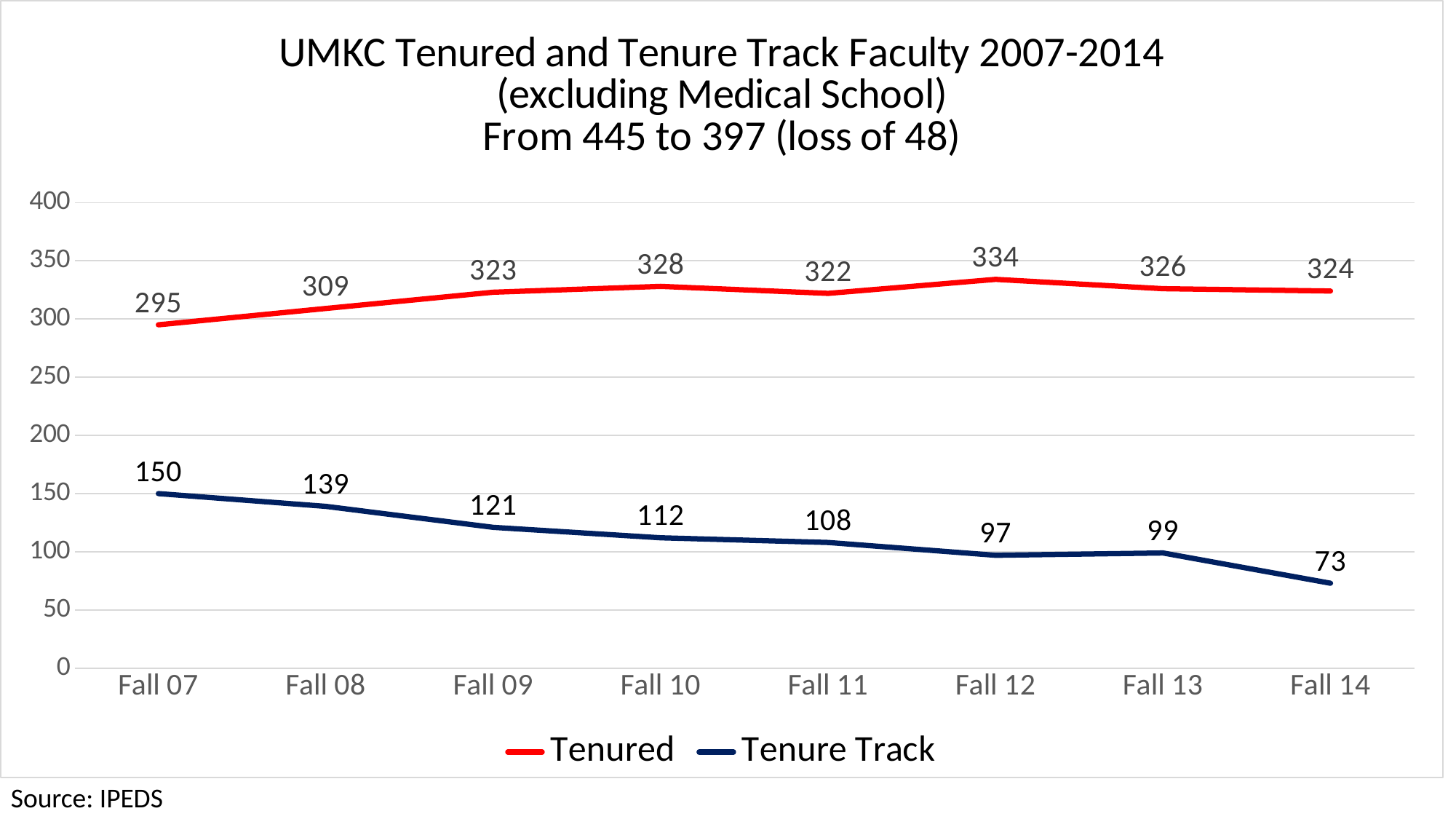
What kind of chart is this? Line chart What colour is the Tenured line? Red Does the Tenure Track series rise or fall from Fall 07 to Fall 14? Fall How many series does the legend list? 2 What is the difference between the Tenure Track values for Fall 07 and Fall 14? 77 In which year is the Tenure Track series lowest? Fall 14 How many years are shown on the x axis? 8 What is the Tenure Track value for Fall 14? 73 Which is larger, the Tenured value for Fall 10 or for Fall 11? Fall 10 What is the Tenured value for Fall 12? 334 In which year is the Tenured series highest? Fall 12 What is the Tenured value for Fall 07? 295